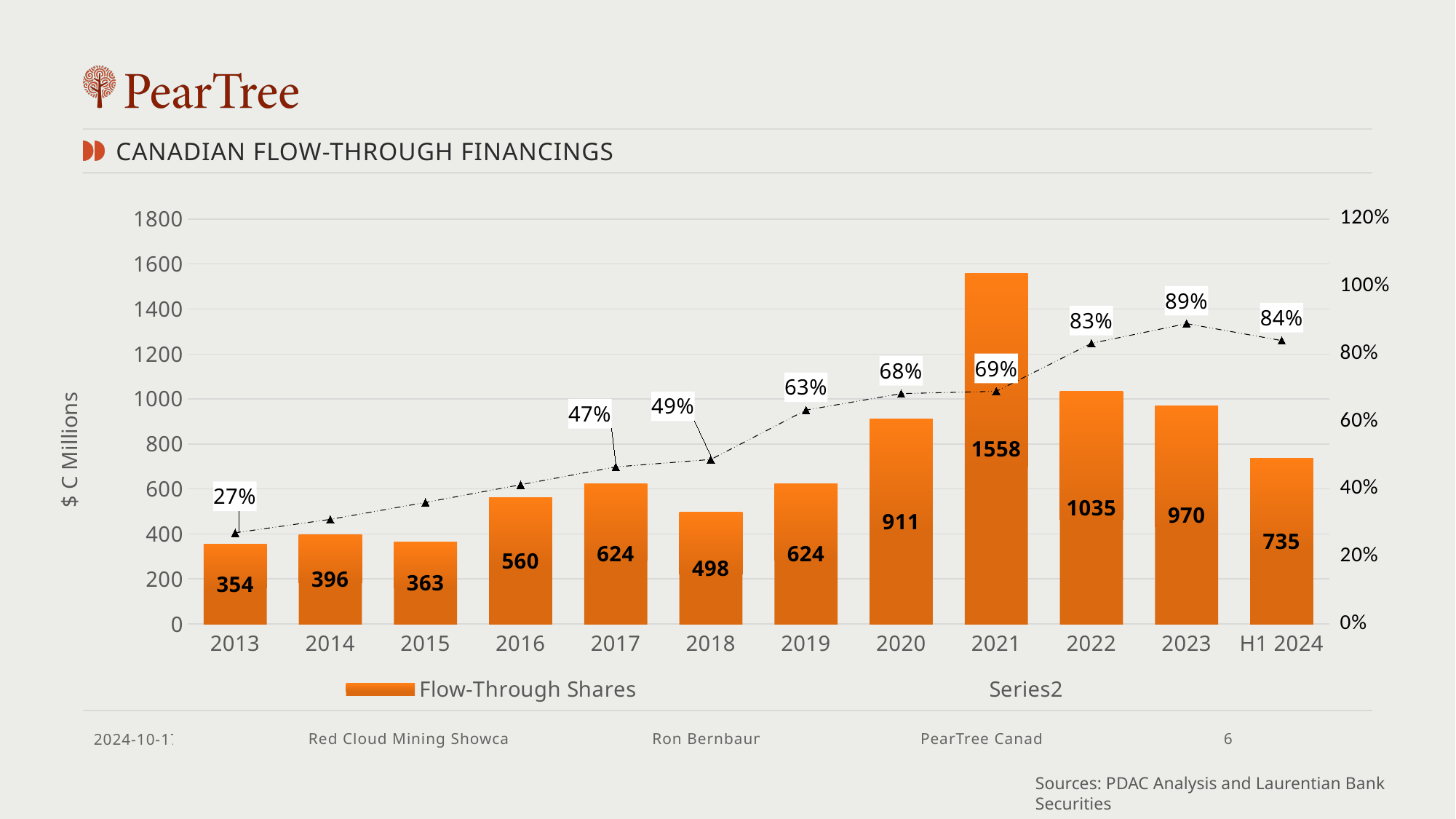
What is the Flow-Through Shares value for 2021? 1558 How many series does the legend list? 2 Is the Series2 value for 2015 greater or less than 40%? less Which year has the lowest Flow-Through Shares value? 2013 How many categories are shown on the x axis? 12 What is the difference between the Flow-Through Shares values for 2021 and 2022? 523 What Series2 percentage is shown for 2023? 89% Which is larger, the Flow-Through Shares value for 2020 or for 2023? 2023 What Series2 percentage is shown for 2013? 27% What is the label on the left vertical axis? $ C Millions Which year has the highest Flow-Through Shares value? 2021 What is the Flow-Through Shares value for 2016? 560